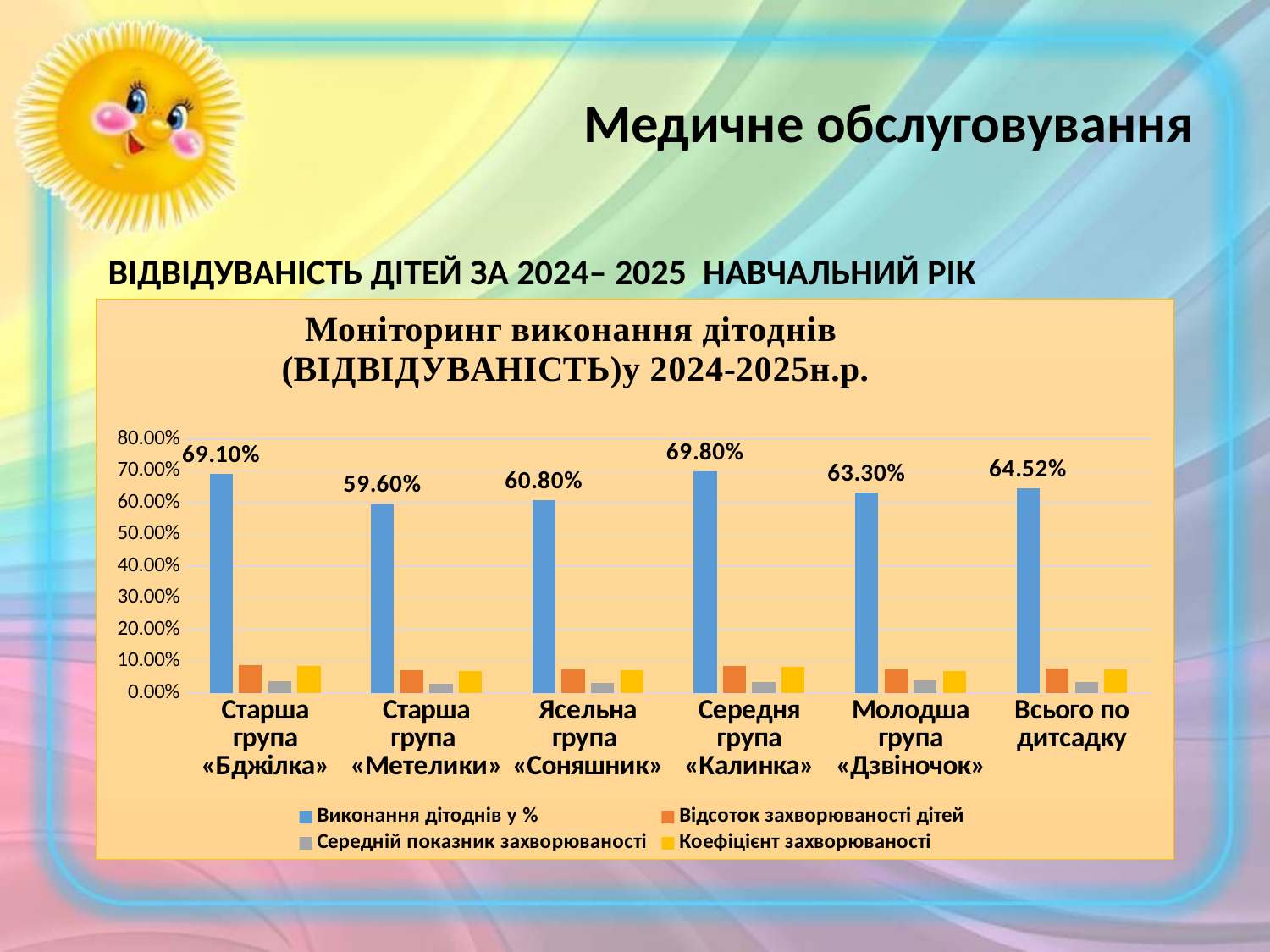
How many groups (categories) are shown on the x axis? 6 Is the value of Відсоток захворюваності дітей for Старша група «Бджілка» greater or less than 10.00%? less What is the value of Виконання дітоднів у % for Старша група «Бджілка»? 69.10% Which has a higher value of Виконання дітоднів у %: Ясельна група «Соняшник» or Молодша група «Дзвіночок»? Молодша група «Дзвіночок» How many series does the legend list? 4 What is the value of Виконання дітоднів у % for Середня група «Калинка»? 69.80% Which group has the lowest value of Виконання дітоднів у %? Старша група «Метелики» What is the difference in Виконання дітоднів у % between Середня група «Калинка» and Старша група «Метелики»? 10.20% What type of chart is shown on the slide? bar chart Which group has the highest value of Виконання дітоднів у %? Середня група «Калинка» What is the value of Виконання дітоднів у % for Всього по дитсадку? 64.52% What colour are the bars for the series Коефіцієнт захворюваності? yellow